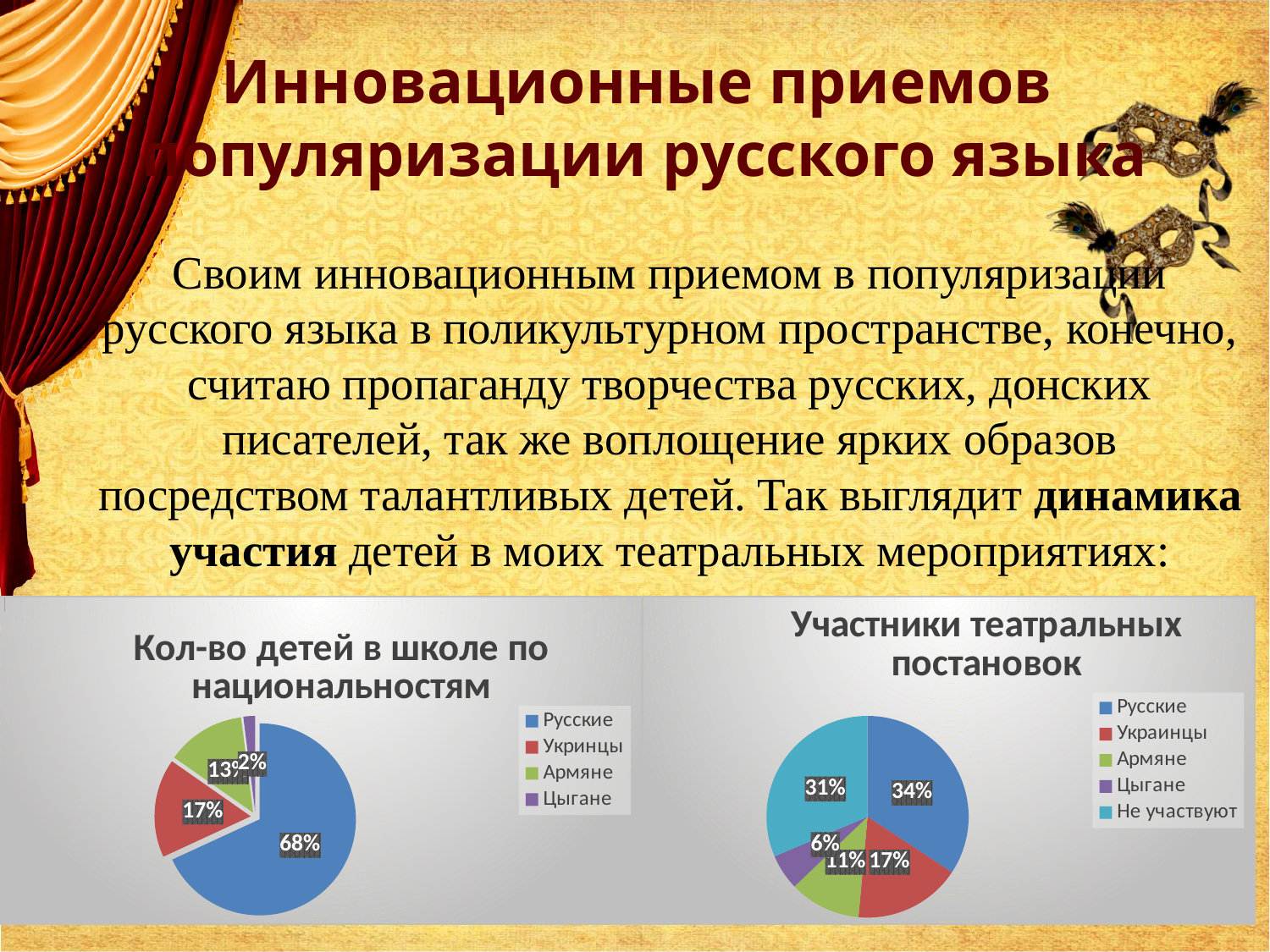
In the right chart "Участники театральных постановок", which is larger: the share for Украинцы or the share for Армяне? Украинцы How many categories does the legend of the right chart "Участники театральных постановок" list? 5 In the left chart "Кол-во детей в школе по национальностям", what is the difference between the Русские and Укринцы shares? 51% In the left chart "Кол-во детей в школе по национальностям", what share is labelled for Русские? 68% How many categories does the legend of the left chart "Кол-во детей в школе по национальностям" list? 4 What type of chart is the left chart titled "Кол-во детей в школе по национальностям"? pie chart In the right chart "Участники театральных постановок", what share is labelled for Не участвуют? 31% In the left chart "Кол-во детей в школе по национальностям", which category has the smallest slice? Цыгане In the right chart "Участники театральных постановок", what share is labelled for Цыгане? 6% In the left chart "Кол-во детей в школе по национальностям", what share is labelled for Армяне? 13% In the right chart "Участники театральных постановок", which category has the largest slice? Русские What is the title of the right chart on the slide? Участники театральных постановок